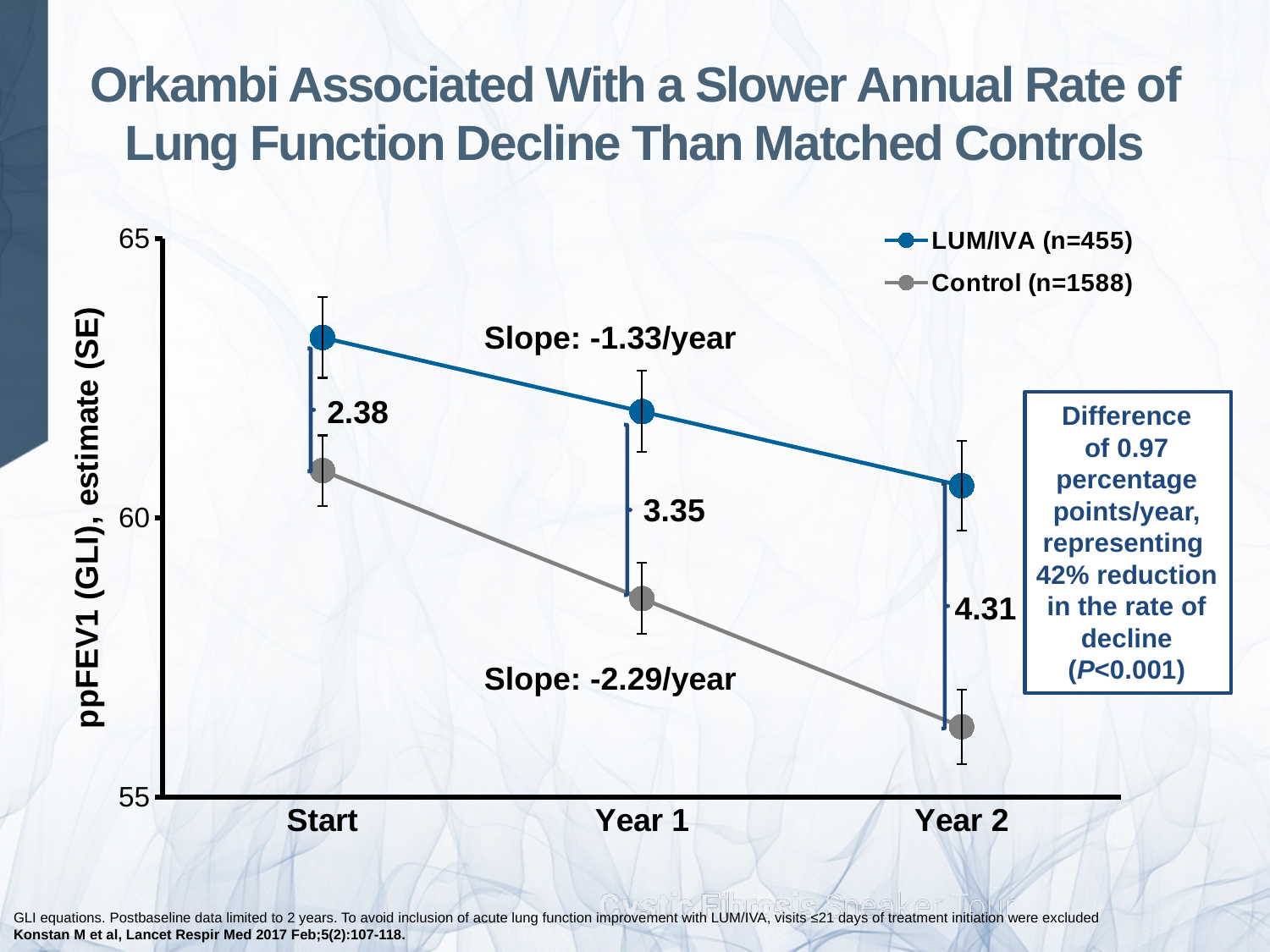
At which time point is the labelled difference between the two groups largest? Year 2 What is the sample size shown in the legend for the Control group? n=1588 What is the labelled difference between the LUM/IVA and Control groups at Year 1? 3.35 Is the ppFEV1 value for Control at Year 2 greater or less than 60? less What is the labelled difference between the LUM/IVA and Control groups at Start? 2.38 What slope is shown for the LUM/IVA line? -1.33/year What kind of chart is shown on the slide? Line chart Which series has the higher ppFEV1 value at Year 2, LUM/IVA or Control? LUM/IVA Do the ppFEV1 values for the Control group rise or fall from Start to Year 2? Fall Is the ppFEV1 value for LUM/IVA at Start greater or less than 60? greater How many series does the legend list? 2 How many time points are plotted along the x axis? 3